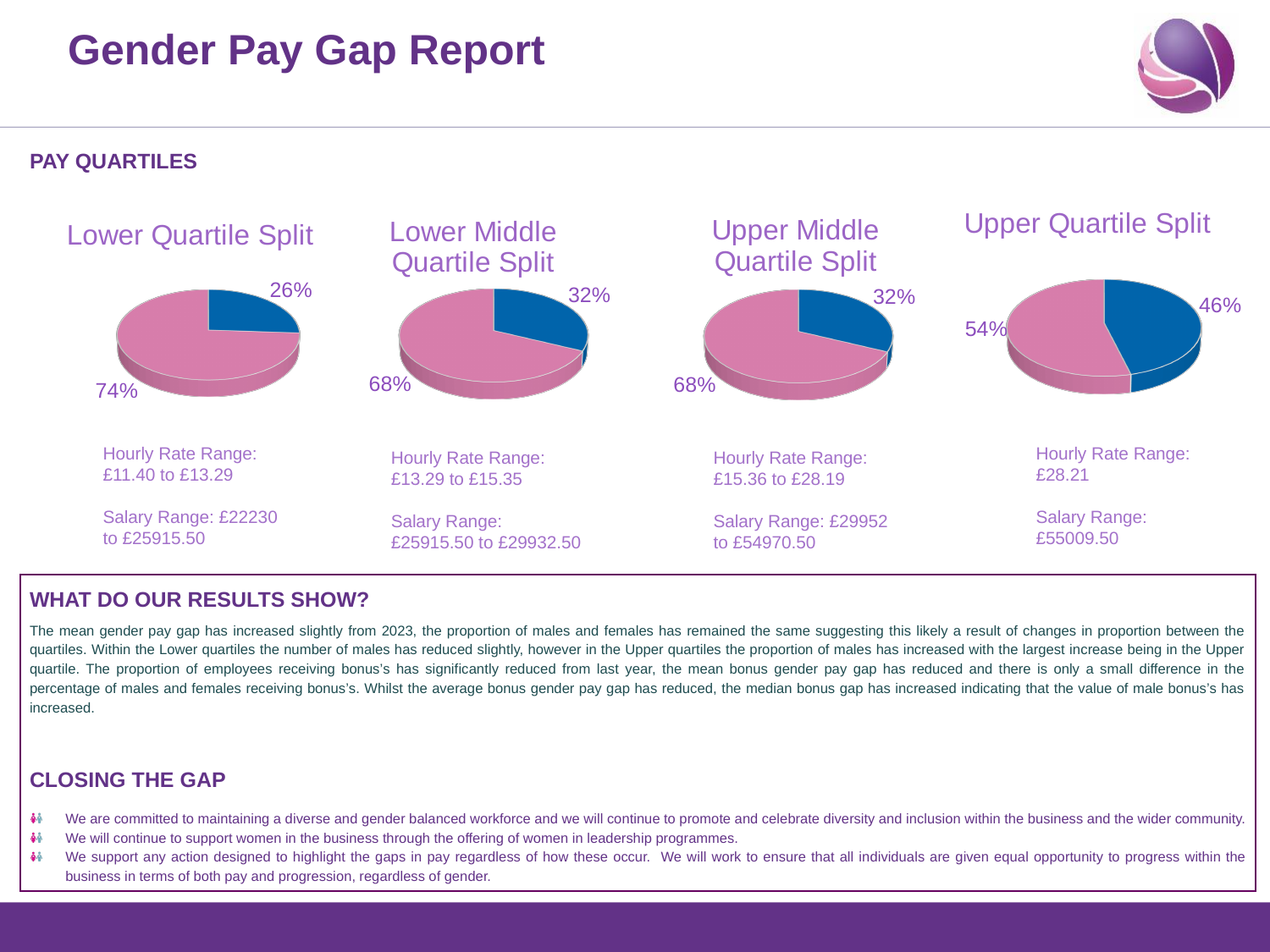
In the Lower Quartile Split chart, what is the difference between the larger and smaller slice percentages? 48% In the Upper Quartile Split chart, what is the difference between the two slices' percentages? 8% What kind of chart is the Lower Quartile Split chart? Pie chart Across the four pie charts, which chart has the largest blue slice? Upper Quartile Split How many slices does the Upper Middle Quartile Split chart have? 2 In the Lower Quartile Split chart, what percentage is shown for the larger slice? 74% In the Upper Middle Quartile Split chart, what percentage is shown for the pink slice? 68% In the Upper Quartile Split chart, is the pink slice larger or smaller than the blue slice? Larger Across the four pie charts, which chart has the smallest blue slice? Lower Quartile Split In the Lower Quartile Split chart, what percentage is shown for the smaller slice? 26% In the Lower Middle Quartile Split chart, what percentage is shown for the blue slice? 32% In the Upper Quartile Split chart, what percentage is shown for the blue slice? 46%